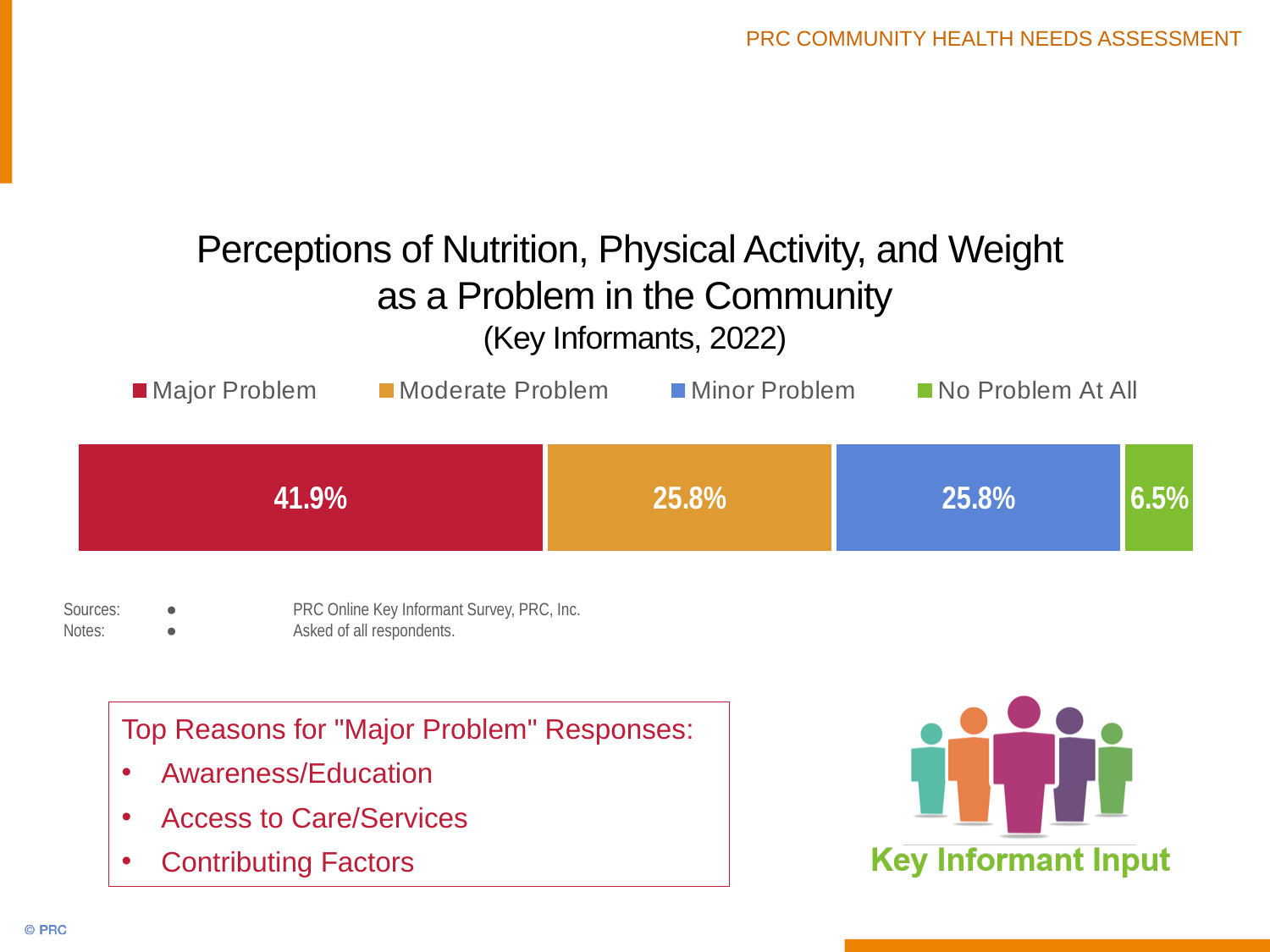
What type of chart is shown on the slide? Stacked bar chart Which response category has the smallest share in the chart? No Problem At All What percentage of key informants responded "No Problem At All"? 6.5% What percentage of key informants responded "Moderate Problem"? 25.8% What is the difference in percentage points between the "Major Problem" and "Moderate Problem" shares? 16.1 Which is larger, the "Major Problem" share or the "Minor Problem" share? Major Problem How many response categories does the legend list? 4 What colour represents the "Minor Problem" category in the chart? Blue Which response category has the largest share in the chart? Major Problem What is the combined share of "Major Problem" and "Moderate Problem" responses? 67.7% What percentage of key informants rated nutrition, physical activity, and weight as a "Major Problem"? 41.9% What is the difference in percentage points between the "Minor Problem" and "No Problem At All" shares? 19.3